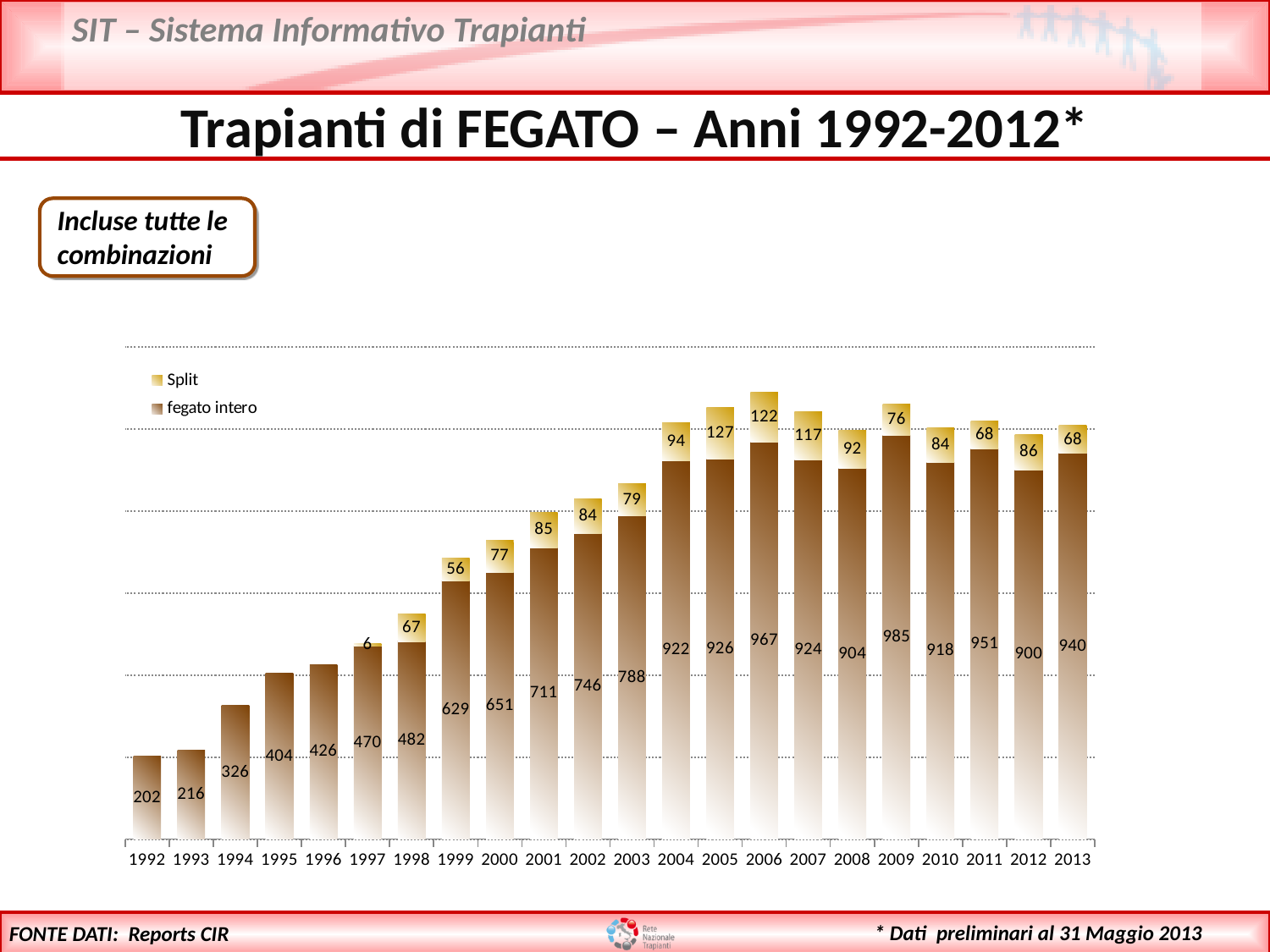
What is the Split value for 2005? 127 What is the difference between the fegato intero values for 2009 and 2008? 81 Which year has the highest fegato intero value? 2009 What is the total of the stacked bar for 2013? 1008 How many series does the legend list? 2 What is the fegato intero value for 1992? 202 Which year has the highest Split value? 2005 What kind of chart is shown on the slide? stacked bar chart Which is larger, the fegato intero value for 2011 or for 2012? 2011 How many years are shown on the x axis? 22 What is the value of fegato intero for 2006? 967 Which year has the lowest fegato intero value? 1992